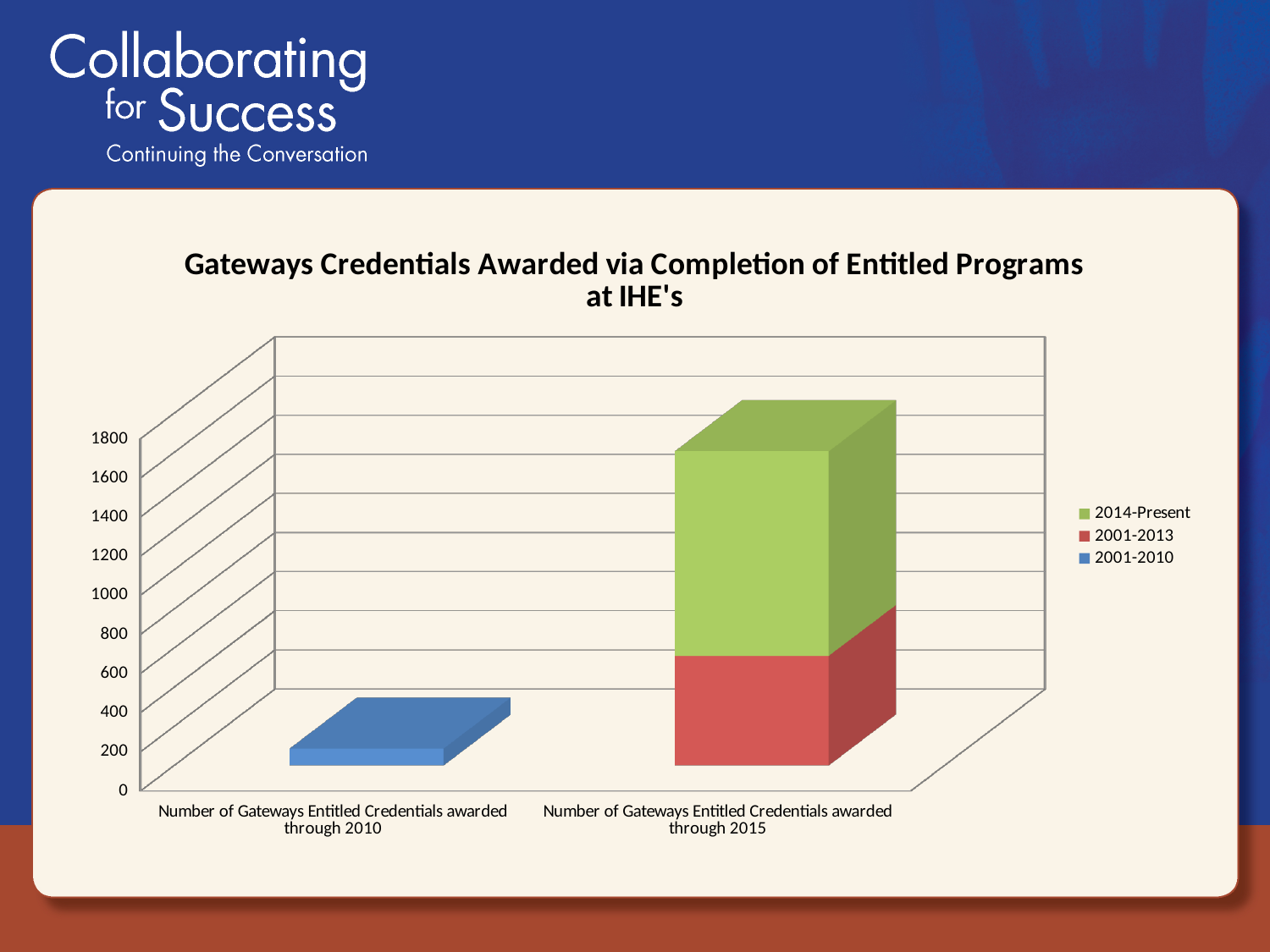
Is the value for Number of Gateways Entitled Credentials awarded through 2010 greater or less than 200? less In the bar for credentials awarded through 2015, which segment is larger: 2014-Present or 2001-2013? 2014-Present How many series does the chart's legend list? 3 What kind of chart is shown on the slide? Bar chart What is the title of the chart? Gateways Credentials Awarded via Completion of Entitled Programs at IHE's Which category has the taller bar: credentials awarded through 2010 or through 2015? Number of Gateways Entitled Credentials awarded through 2015 Is the 2001-2013 segment of the bar for credentials awarded through 2015 greater or less than 400? greater Which colour represents the 2014-Present series in the chart? Green Is the 2014-Present segment of the bar for credentials awarded through 2015 greater or less than 800? greater How many categories are shown on the x axis of the chart? 2